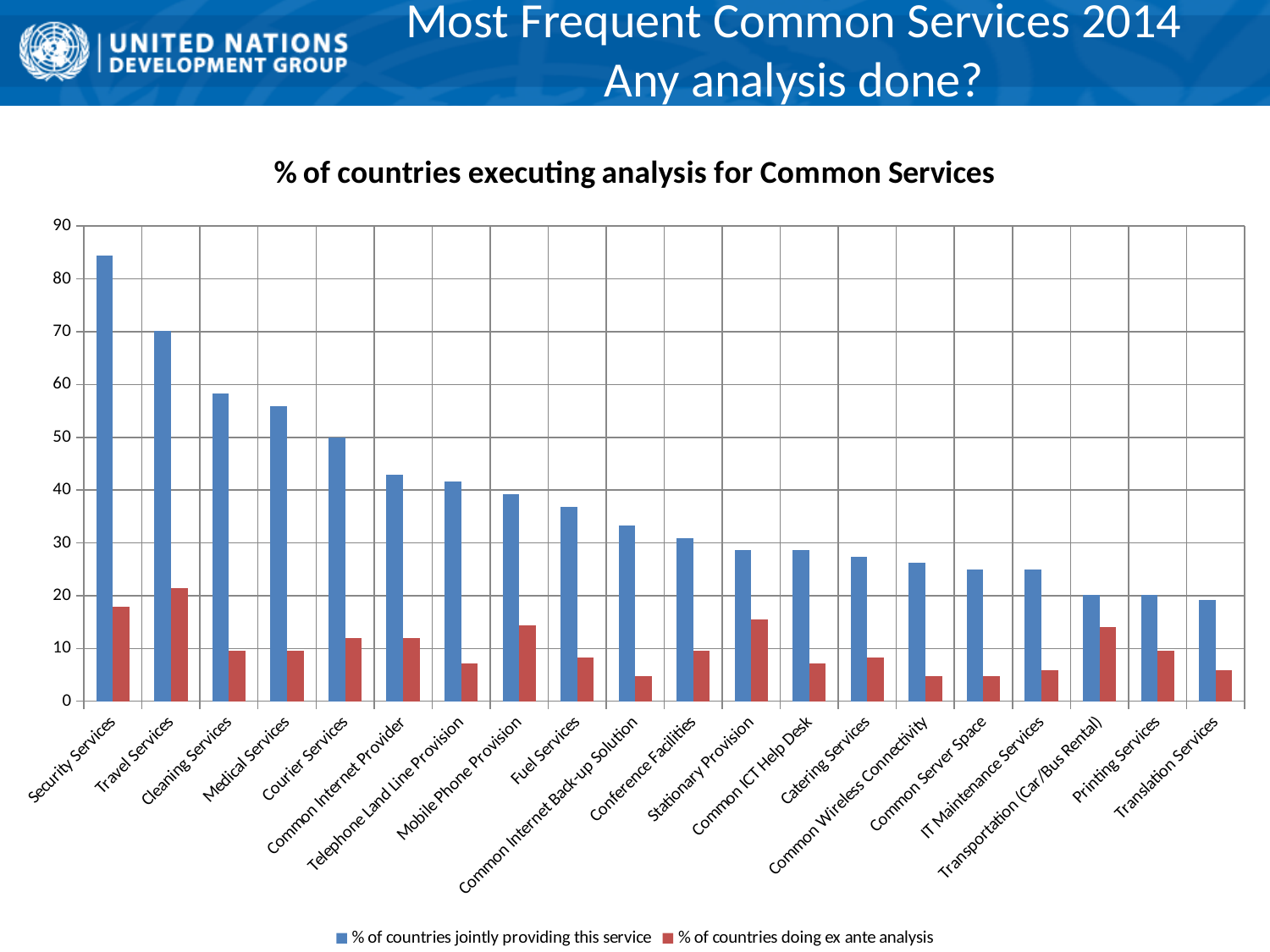
Which colour represents % of countries doing ex ante analysis in the legend? red Which service has the highest value for % of countries doing ex ante analysis? Travel Services What is the title of the chart? % of countries executing analysis for Common Services How many series does the legend list? 2 Do the values for % of countries jointly providing this service generally rise or fall from left to right along the x axis? fall What kind of chart is shown on the slide? bar chart Is the value for Security Services in the % of countries jointly providing this service series greater or less than 80? greater Which is larger for Mobile Phone Provision: % of countries jointly providing this service or % of countries doing ex ante analysis? % of countries jointly providing this service Which service has the highest value for % of countries jointly providing this service? Security Services Is the value for Cleaning Services in the % of countries jointly providing this service series greater or less than 50? greater How many service categories are shown on the x axis? 20